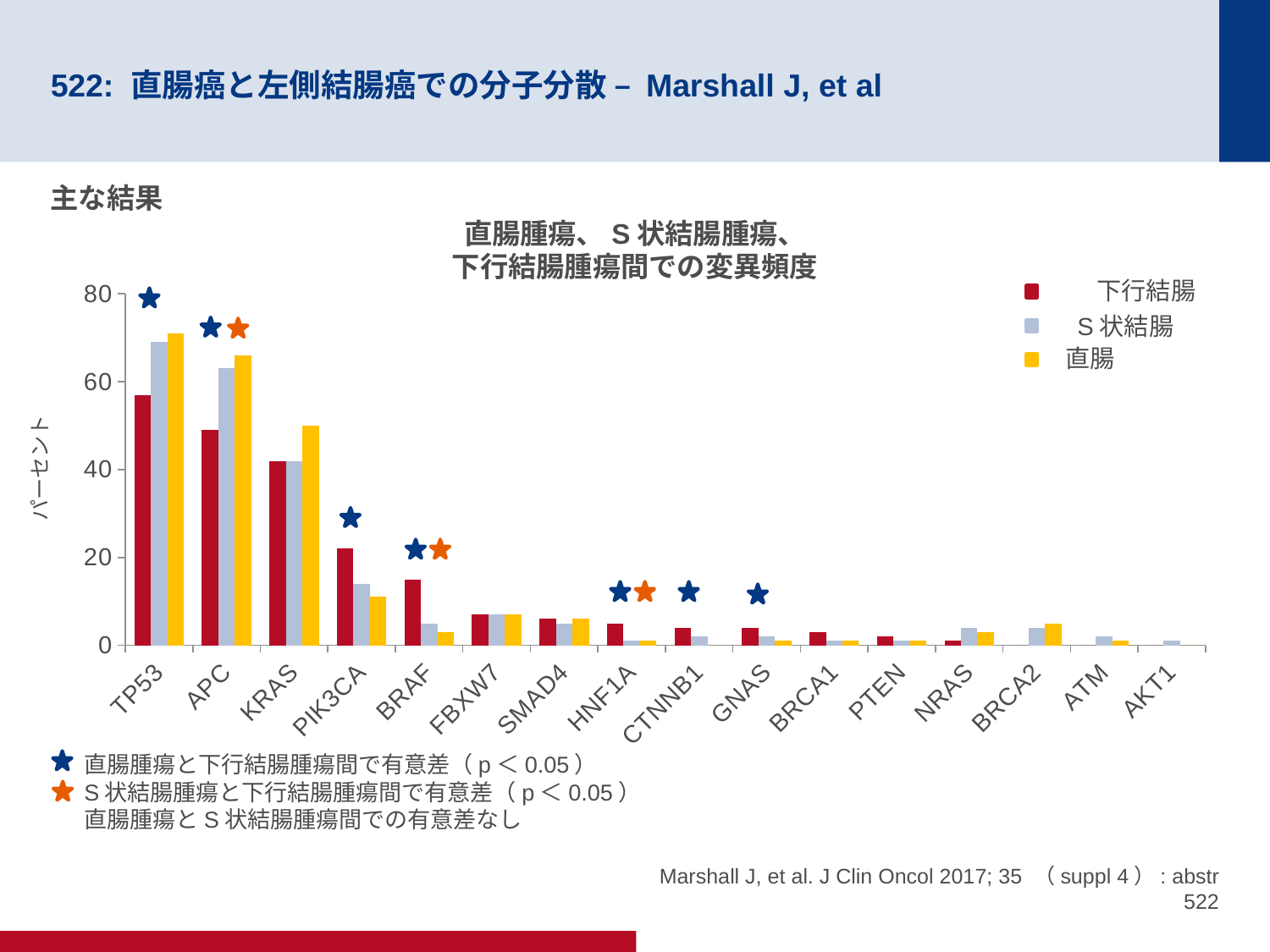
Which gene has the highest value for the 下行結腸 series? TP53 How many genes are shown along the x axis? 16 How many series does the legend list? 3 What kind of chart is shown on the slide? bar chart For BRAF, which is larger: the 下行結腸 value or the 直腸 value? 下行結腸 Which gene has the highest value for the 直腸 series? TP53 Is the 直腸 value for TP53 greater or less than 60? greater For KRAS, which is larger: the 直腸 value or the 下行結腸 value? 直腸 Is the 下行結腸 value for BRAF greater or less than 20? less Which colour represents the 直腸 series in the legend? yellow For APC, which is larger: the 直腸 value or the 下行結腸 value? 直腸 Is the 下行結腸 value for APC greater or less than 40? greater